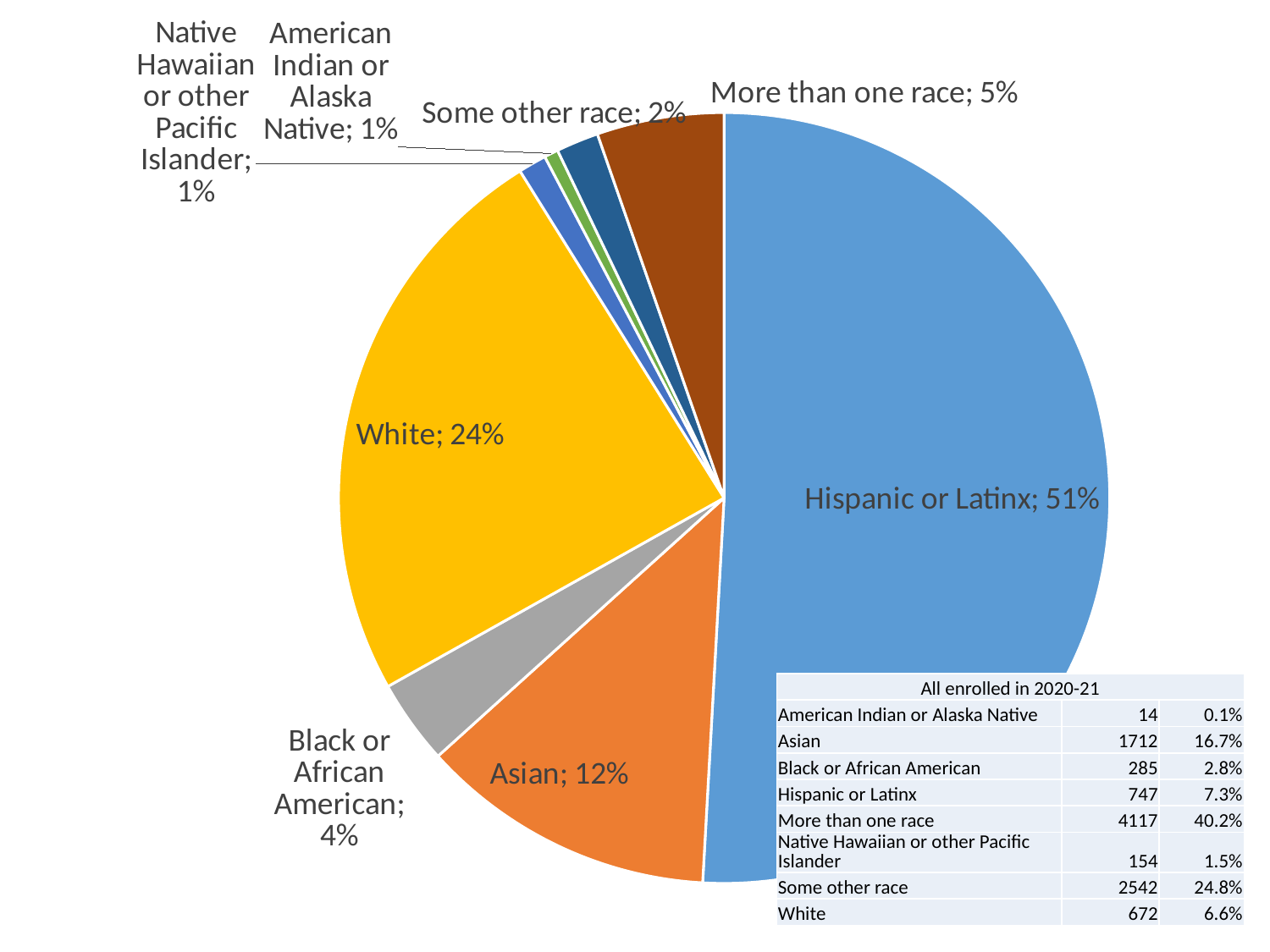
How many slices does the pie chart have? 8 What is the value shown for White? 24% What kind of chart is shown on the slide? pie chart What colour is the Hispanic or Latinx slice? blue What is the value shown for More than one race? 5% What is the value shown for Black or African American? 4% What share of the pie does Hispanic or Latinx represent? 51% What is the difference in percentage points between the White slice and the Asian slice? 12 Which category has the largest slice of the pie? Hispanic or Latinx What is the value shown for Some other race? 2% Which is larger, the slice for White or the slice for Asian? White What is the value shown for Asian? 12%